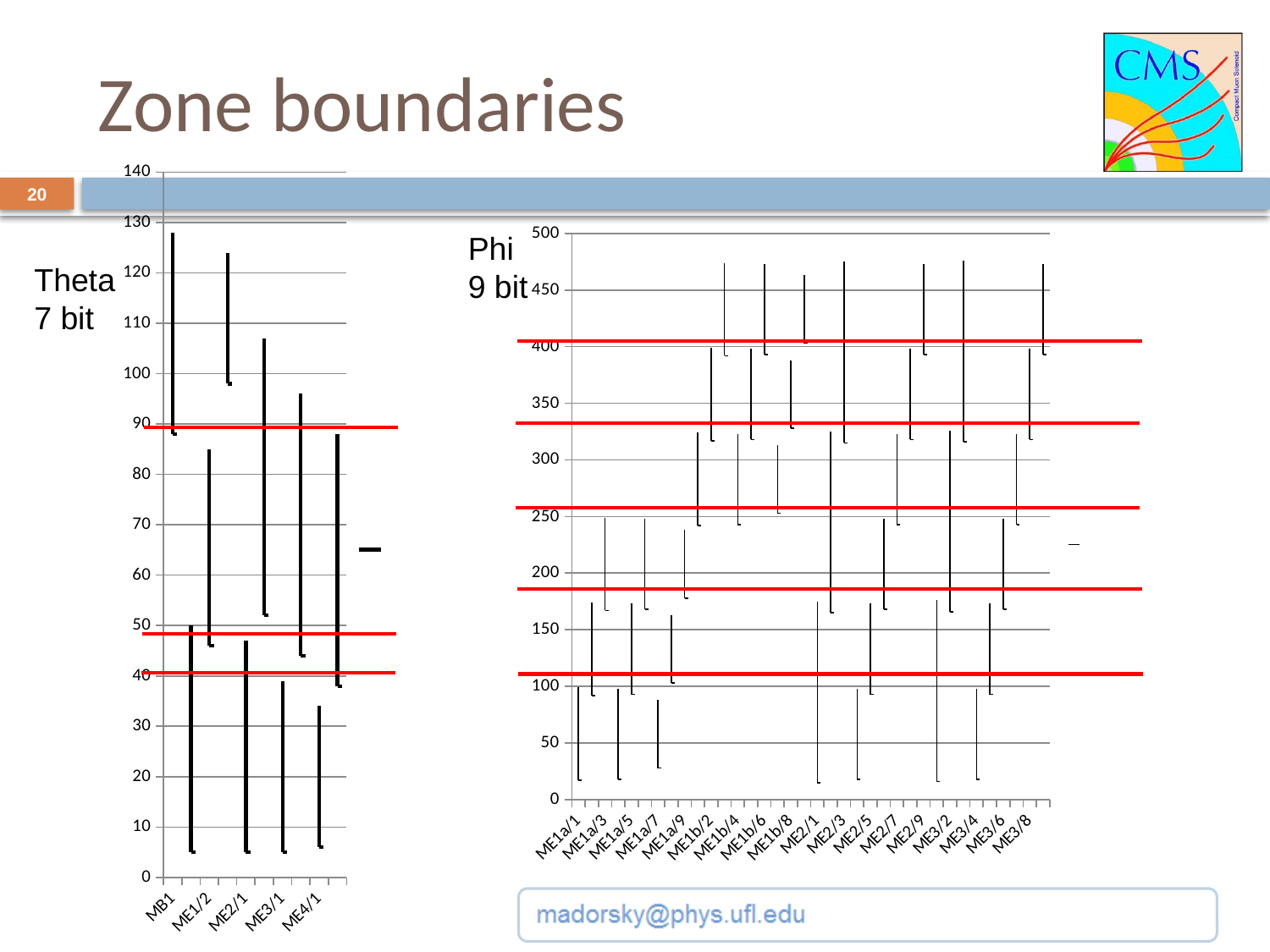
On the Theta 7 bit chart, which category's line reaches higher: MB1 or ME2/1? MB1 On the Theta 7 bit chart, is the top of the ME4/1 line greater or less than 90? less On the Phi 9 bit chart, how many category labels are shown on the x axis? 18 On the Theta 7 bit chart, is the top of the ME2/1 line greater or less than 110? less On the Phi 9 bit chart, what is the highest value shown on the y axis? 500 On the Phi 9 bit chart, is the top of the ME1a/1 line greater or less than 150? less On the Theta 7 bit chart, which category's line reaches the highest value? MB1 On the Theta 7 bit chart, how many categories are labeled on the x axis? 5 On the Theta 7 bit chart, what is the highest value shown on the y axis? 140